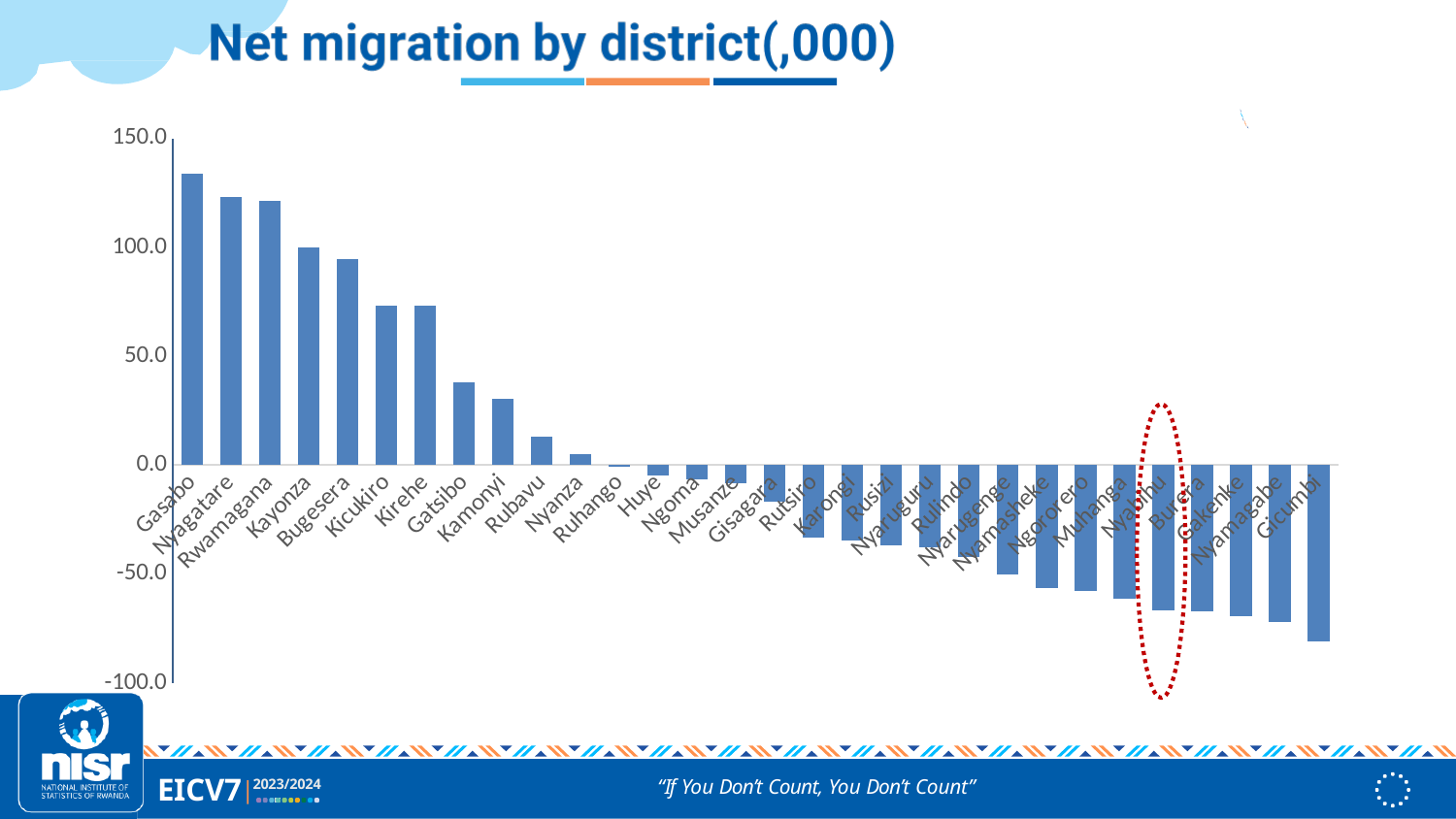
Is the value for Gasabo greater or less than 100? greater How many districts are plotted in the chart? 30 Which district has the highest net migration? Gasabo Is the value for Kicukiro greater or less than 50? greater What kind of chart is shown on the slide? Bar chart Is the value for Gatsibo greater or less than 50? less What is the title of the chart? Net migration by district(,000) Which district has the lowest net migration? Gicumbi Do the values rise or fall moving from left to right along the x axis? Fall Which has the larger net migration, Gasabo or Nyagatare? Gasabo